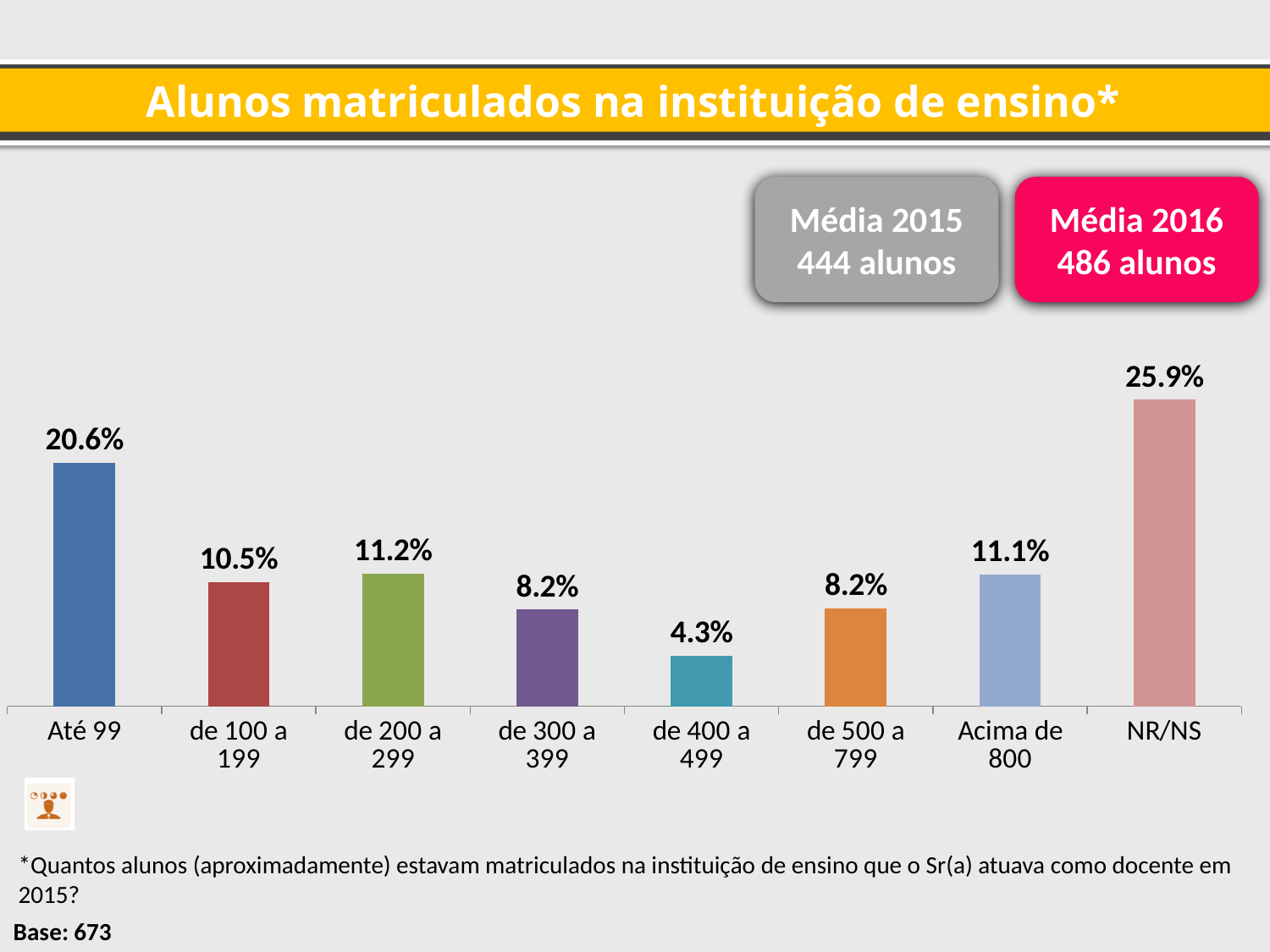
Which category has the highest value? NR/NS What is the difference between the values for 'NR/NS' and 'Até 99'? 5.3% What is the value for the 'Acima de 800' category? 11.1% What kind of chart is shown on the slide? bar chart How many categories are shown on the x axis? 8 What is the value for the 'Até 99' category? 20.6% What is the 'Média 2016' value shown on the slide? 486 alunos Which is larger, the value for 'de 100 a 199' or the value for 'de 500 a 799'? de 100 a 199 What is the title of the chart? Alunos matriculados na instituição de ensino* Which category has the lowest value? de 400 a 499 What is the difference between the values for 'de 200 a 299' and 'de 100 a 199'? 0.7% What is the value for the 'de 400 a 499' category? 4.3%